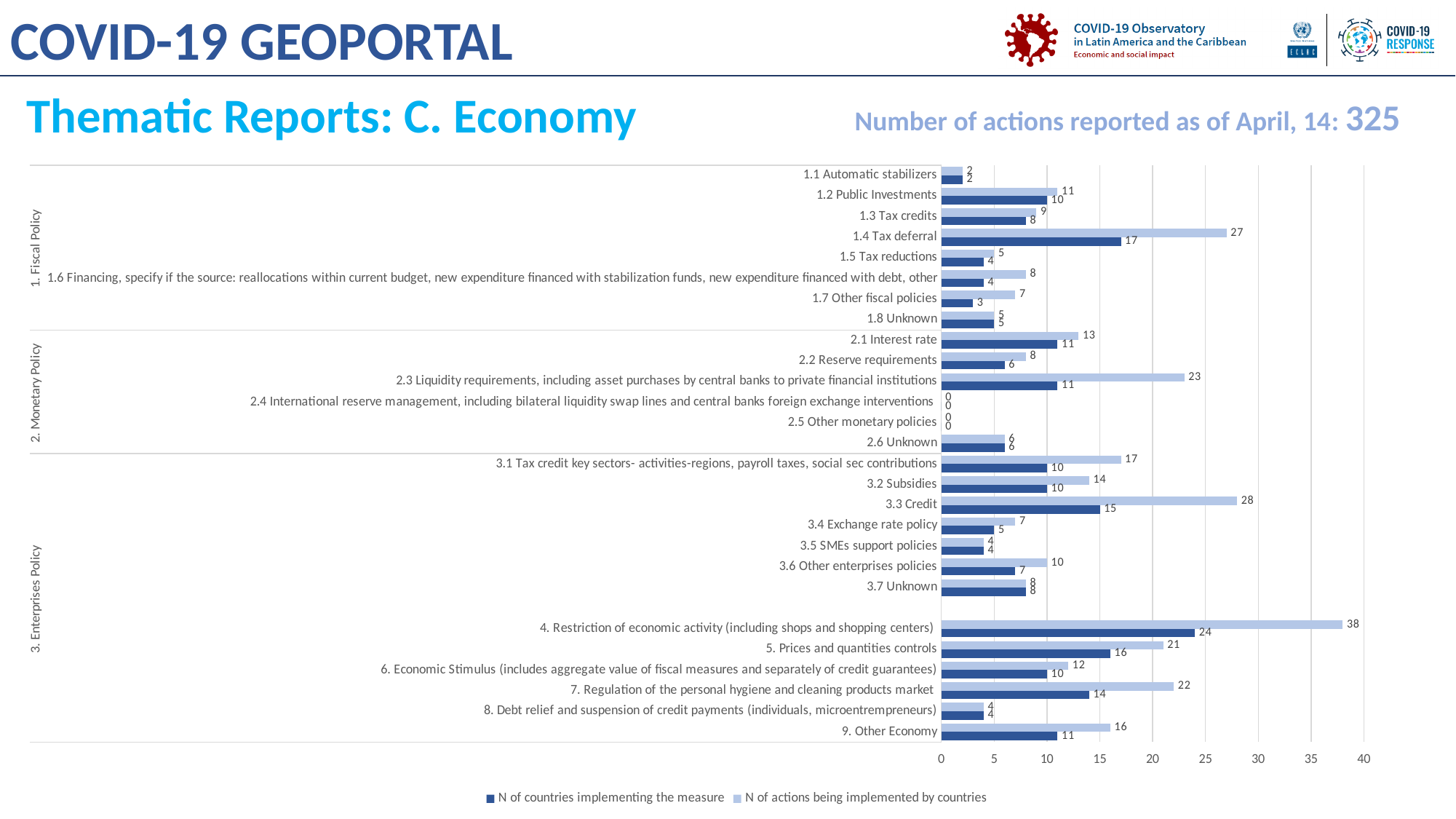
How many series does the legend list? 2 What is the number of countries implementing the measure for 3.3 Credit? 15 What is the difference between the number of actions and the number of countries for 2.3 Liquidity requirements, including asset purchases by central banks to private financial institutions? 12 What is the number of actions being implemented by countries for 2.4 International reserve management, including bilateral liquidity swap lines and central banks foreign exchange interventions? 0 What is the number of countries implementing the measure for 4. Restriction of economic activity (including shops and shopping centers)? 24 Which is larger: the number of actions for 5. Prices and quantities controls or for 7. Regulation of the personal hygiene and cleaning products market? 7. Regulation of the personal hygiene and cleaning products market What is the total number of actions reported as of April 14, as stated on the slide? 325 What is the number of actions being implemented by countries for 3.1 Tax credit key sectors- activities-regions, payroll taxes, social sec contributions? 17 What is the number of actions being implemented by countries for 1.4 Tax deferral? 27 Which category has the highest number of actions being implemented by countries? 4. Restriction of economic activity (including shops and shopping centers) What kind of chart is shown on the slide? bar chart What is the number of countries implementing the measure for 9. Other Economy? 11